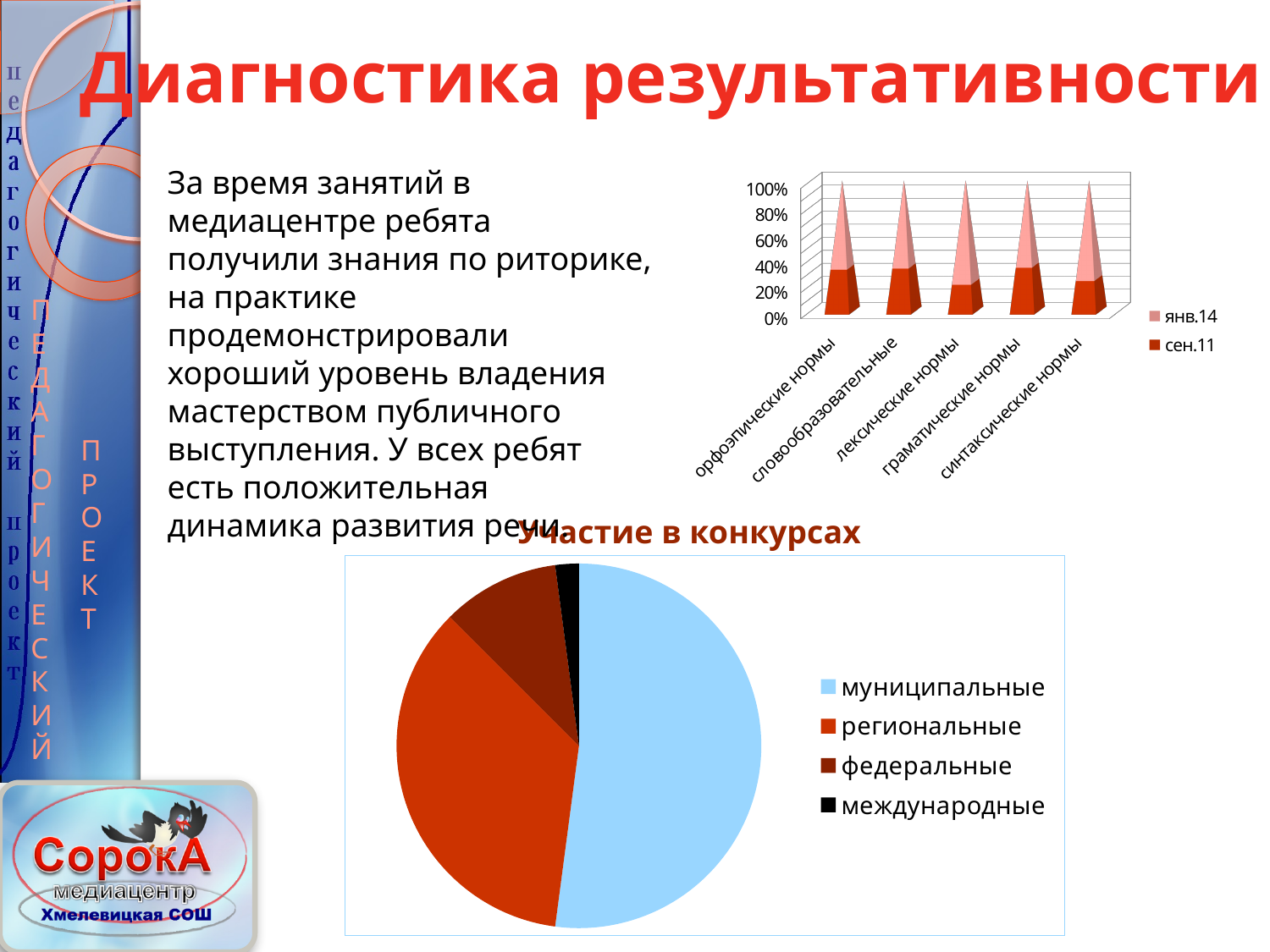
In the pie chart 'Участие в конкурсах', which category has the smallest share? международные In the pie chart 'Участие в конкурсах', what colour is the slice for муниципальные? light blue In the top-right chart, which series has the higher value for синтаксические нормы: янв.14 or сен.11? янв.14 How many slices does the pie chart 'Участие в конкурсах' have? 4 How many series does the legend of the top-right chart list? 2 In the pie chart 'Участие в конкурсах', which category has the largest share? муниципальные In the pie chart 'Участие в конкурсах', which share is larger: региональные or федеральные? региональные How many categories are shown on the x axis of the top-right chart? 5 What kind of chart is the chart titled 'Участие в конкурсах'? pie chart In the top-right chart, is the value of сен.11 for лексические нормы greater or less than 60%? less What are the two series named in the legend of the top-right chart? янв.14 and сен.11